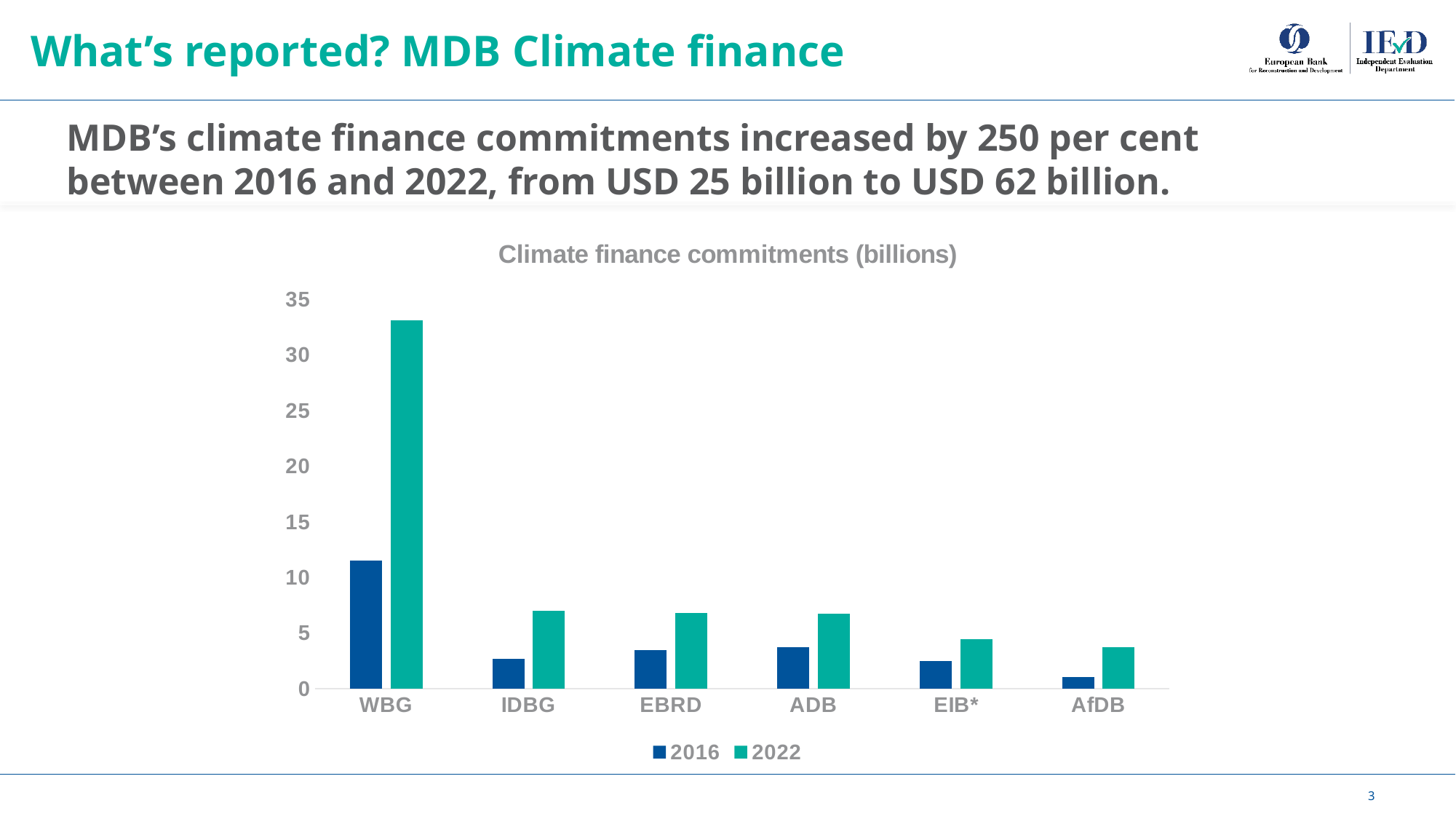
Which institution has the lowest 2016 climate finance commitment? AfDB Which institution has the highest 2022 climate finance commitment? WBG Which is larger: the 2022 value for WBG or the 2022 value for IDBG? WBG Which colour represents the 2022 series in the chart? Teal (green) What kind of chart is shown on the slide? Bar chart Is the 2022 value for IDBG greater or less than 5? greater What is the title of the chart? Climate finance commitments (billions) How many series does the legend list? 2 Is the 2016 value for WBG greater or less than 10? greater Is the 2022 value for EIB* greater or less than 5? less How many institutions are shown on the x axis of the chart? 6